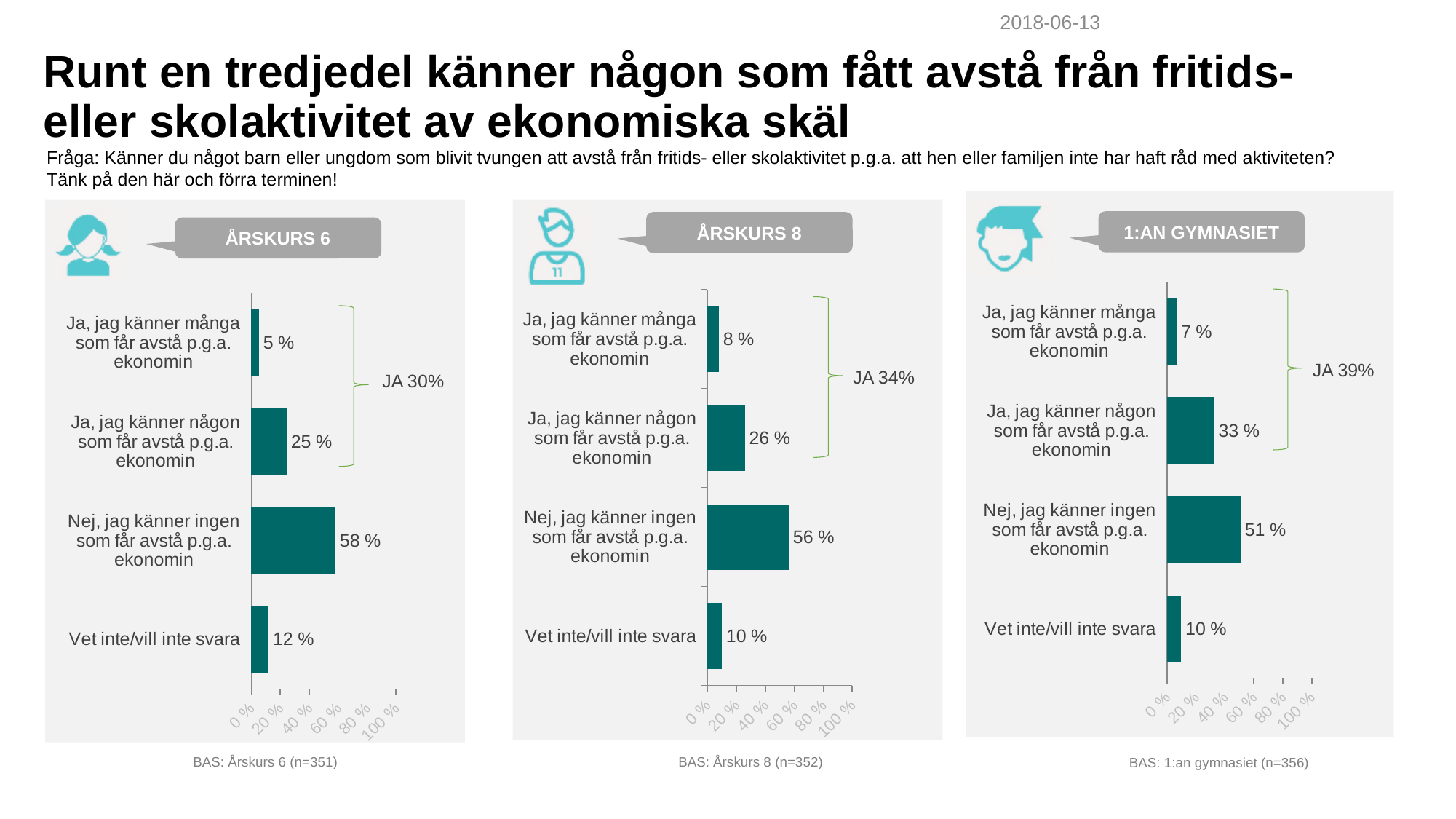
What kind of chart is the ÅRSKURS 6 chart? bar chart In the ÅRSKURS 8 chart, what is the difference between "Nej, jag känner ingen" (56 %) and "Ja, jag känner någon" (26 %)? 30 % What is the base (n) stated below the ÅRSKURS 8 chart? n=352 In the 1:AN GYMNASIET chart, what combined "JA" share is shown by the bracket? JA 39% In the 1:AN GYMNASIET chart, what is the value for "Ja, jag känner någon som får avstå p.g.a. ekonomin"? 33 % Which is larger: "Vet inte/vill inte svara" in the ÅRSKURS 6 chart or in the ÅRSKURS 8 chart? ÅRSKURS 6 In the ÅRSKURS 6 chart, which category has the lowest value? Ja, jag känner många som får avstå p.g.a. ekonomin How many categories does the ÅRSKURS 8 chart show? 4 In the ÅRSKURS 6 chart, what is the value for "Nej, jag känner ingen som får avstå p.g.a. ekonomin"? 58 % In the ÅRSKURS 8 chart, what is the value for "Ja, jag känner många som får avstå p.g.a. ekonomin"? 8 % In the 1:AN GYMNASIET chart, which category has the highest value? Nej, jag känner ingen som får avstå p.g.a. ekonomin In the 1:AN GYMNASIET chart, is the value for "Nej, jag känner ingen som får avstå p.g.a. ekonomin" greater or less than 40 %? greater